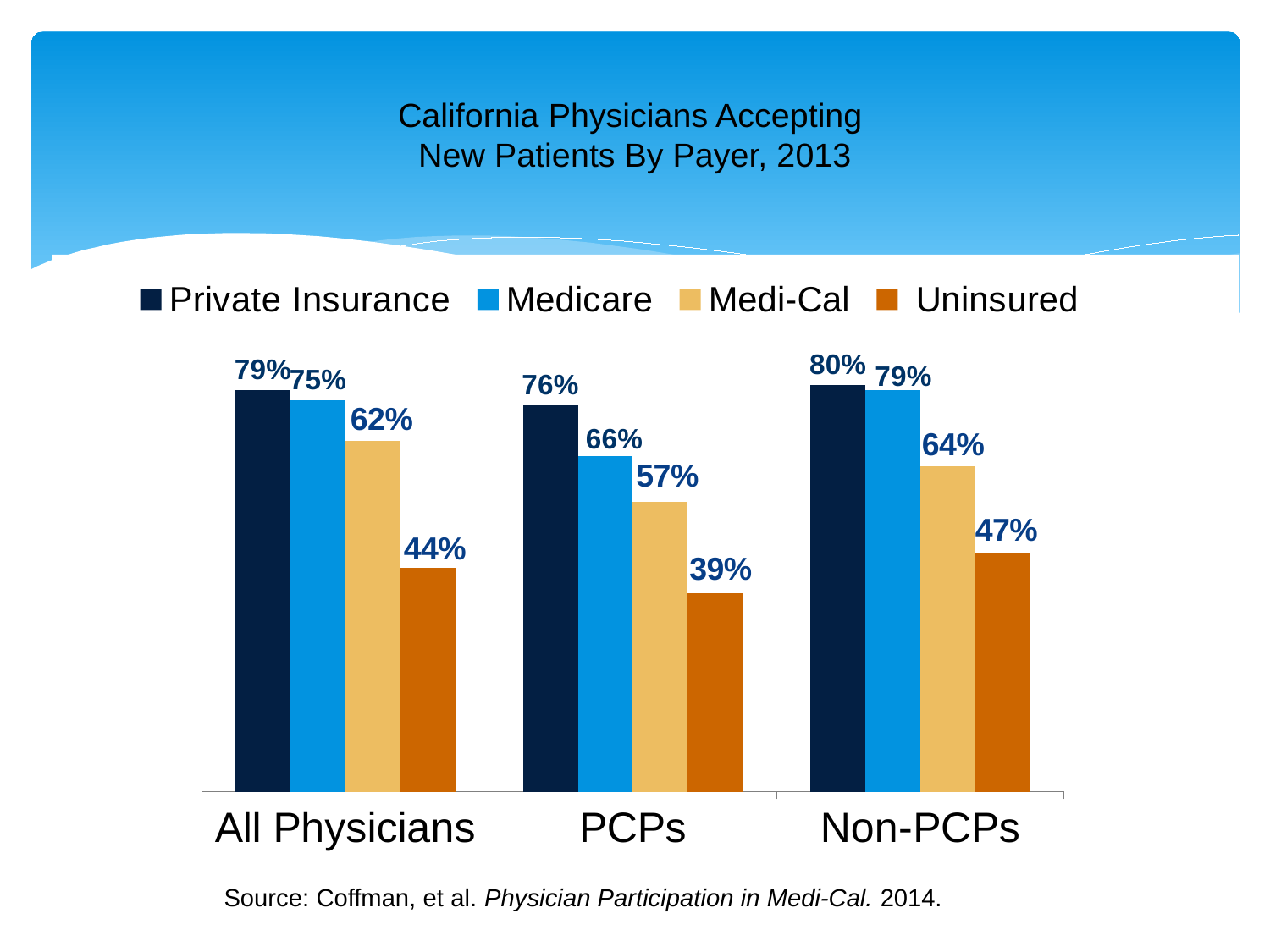
Which payer has the highest value for Non-PCPs? Private Insurance What is the value for Private Insurance among All Physicians? 79% Which payer has the lowest value for PCPs? Uninsured What kind of chart is shown on the slide? Bar chart What is the value for Uninsured among Non-PCPs? 47% How many series does the legend list? 4 What is the difference between the Medicare values for Non-PCPs and PCPs? 13% What is the difference between Private Insurance and Uninsured for All Physicians? 35% What is the title of the chart? California Physicians Accepting New Patients By Payer, 2013 How many physician groups are shown on the x axis? 3 What percentage of PCPs accept new Medi-Cal patients? 57%